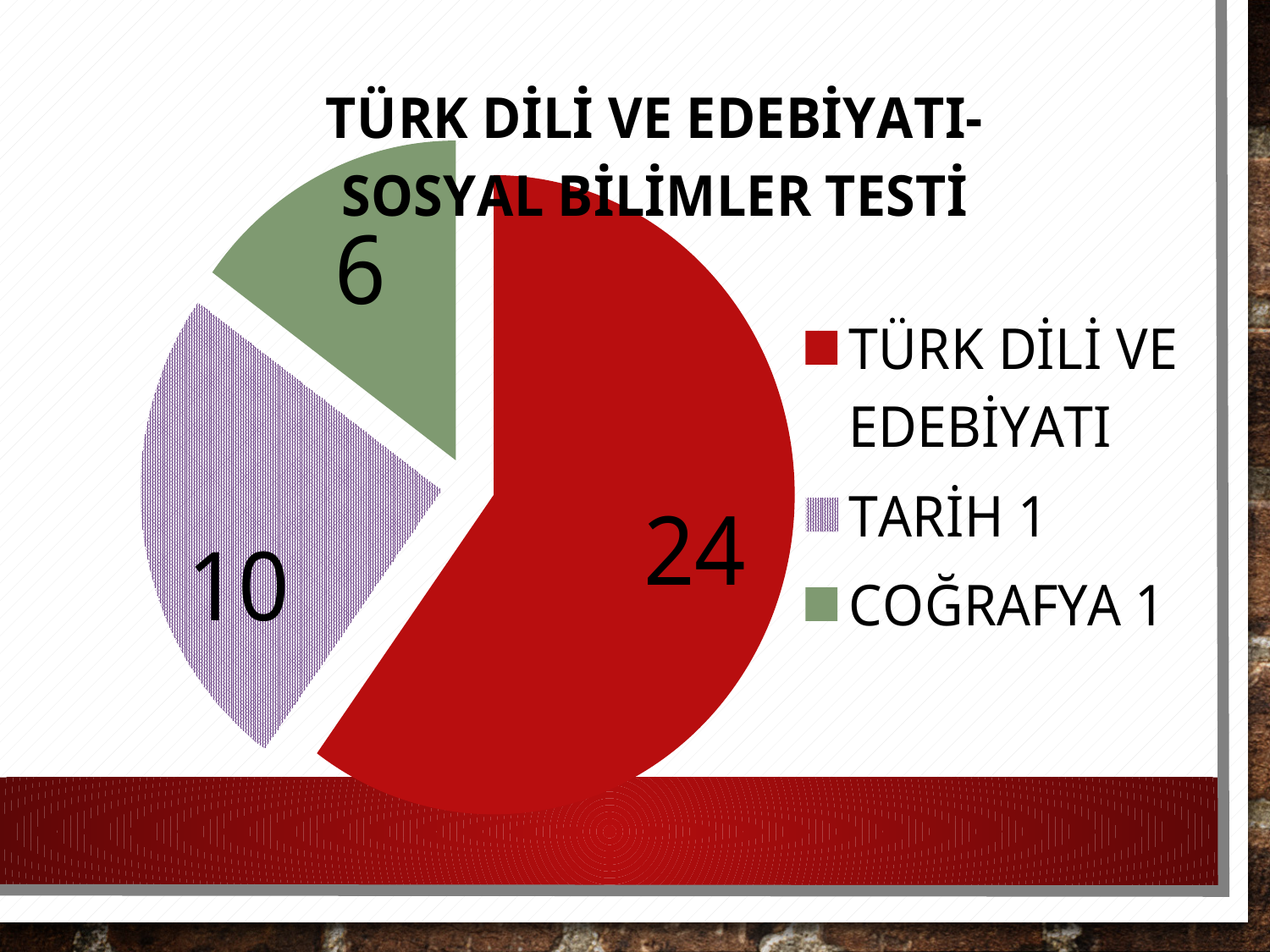
What is the value for TARİH 1? 10 What is the difference between the values for TARİH 1 and COĞRAFYA 1? 4 What type of chart is shown on the slide? Pie chart How many categories does the pie chart have? 3 Which is larger, the value for TARİH 1 or the value for COĞRAFYA 1? TARİH 1 What is the value for COĞRAFYA 1? 6 What is the title of the chart? TÜRK DİLİ VE EDEBİYATI-SOSYAL BİLİMLER TESTİ Which category has the largest slice of the pie? TÜRK DİLİ VE EDEBİYATI Which category has the smallest slice of the pie? COĞRAFYA 1 What is the value for TÜRK DİLİ VE EDEBİYATI? 24 What share of the pie does TÜRK DİLİ VE EDEBİYATI represent? 60% What is the difference between the values for TÜRK DİLİ VE EDEBİYATI and TARİH 1? 14